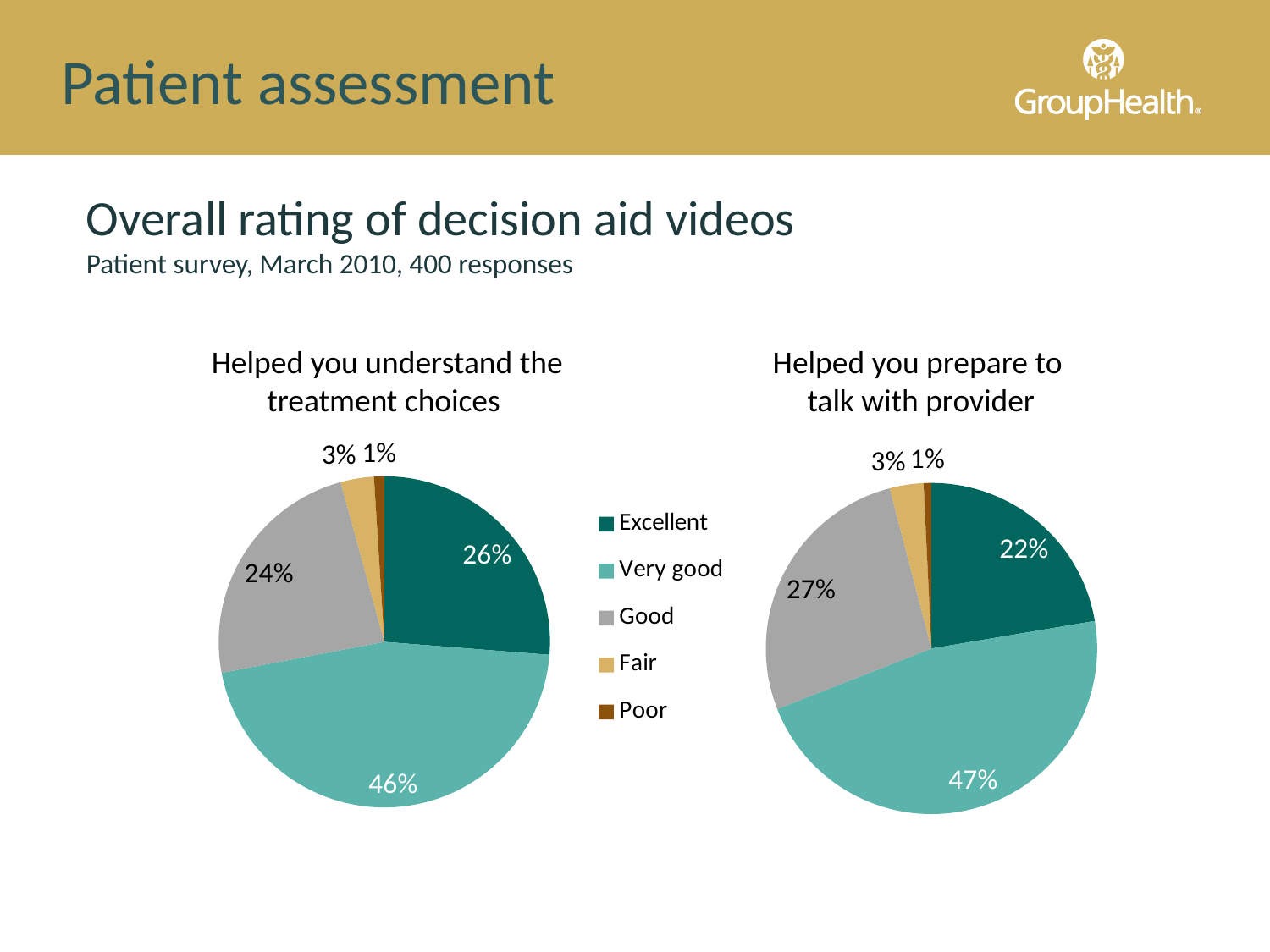
In the 'Helped you understand the treatment choices' chart, which rating has the smallest share? Poor In the 'Helped you understand the treatment choices' chart, what share of responses rated the video Fair? 3% How many rating categories does the legend list? 5 In the 'Helped you prepare to talk with provider' chart, which rating has the largest share? Very good In the 'Helped you understand the treatment choices' chart, what share of responses rated the video Very good? 46% In the 'Helped you prepare to talk with provider' chart, what is the combined share of Excellent and Very good ratings? 69% What type of chart is used on this slide? Pie chart In the 'Helped you prepare to talk with provider' chart, what share of responses rated the video Excellent? 22% In the 'Helped you understand the treatment choices' chart, what is the difference between the Very good share and the Good share? 22% In the 'Helped you understand the treatment choices' chart, what share of responses rated the video Excellent? 26% In the 'Helped you prepare to talk with provider' chart, what share of responses rated the video Good? 27% Which chart has the larger Excellent share, 'Helped you understand the treatment choices' or 'Helped you prepare to talk with provider'? Helped you understand the treatment choices